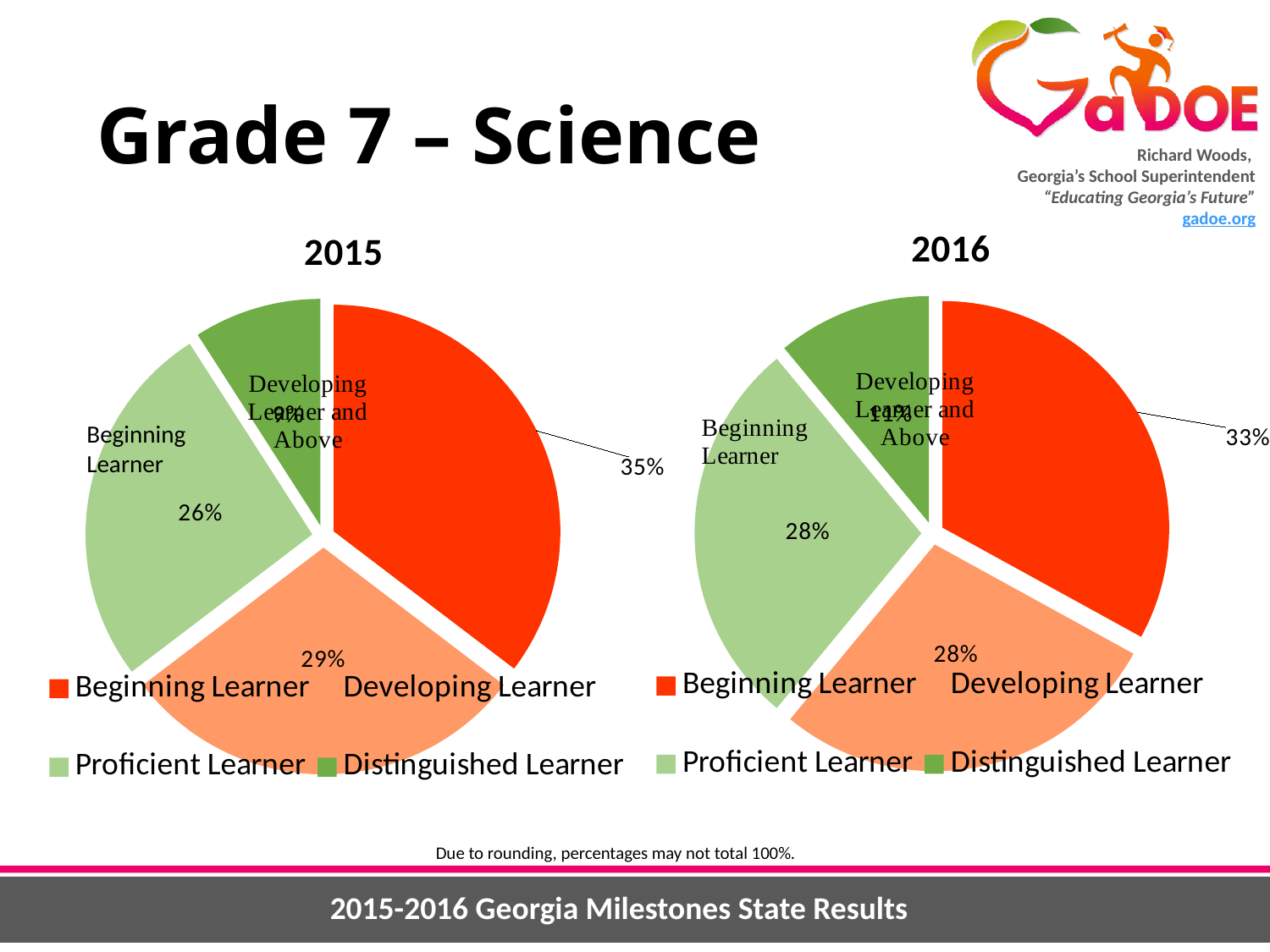
In the 2016 pie chart, what percentage is shown for Beginning Learner? 33% In the 2015 pie chart, which is larger: Developing Learner or Proficient Learner? Developing Learner In the 2016 pie chart, which category has the smallest share? Distinguished Learner In the 2015 pie chart, what is the difference in percentage points between Beginning Learner and Developing Learner? 6 percentage points In the 2015 pie chart, what percentage is shown for Proficient Learner? 26% In the 2015 pie chart, which category has the smallest share? Distinguished Learner In the 2015 pie chart, which category has the largest share? Beginning Learner What type of chart is used for the 2015 and 2016 results? Pie chart In the 2016 pie chart, what percentage is shown for Proficient Learner? 28% In the 2015 pie chart, what percentage is shown for Beginning Learner? 35% How many categories does the legend of the 2016 chart list? 4 In the 2015 pie chart, what percentage is shown for Developing Learner? 29%